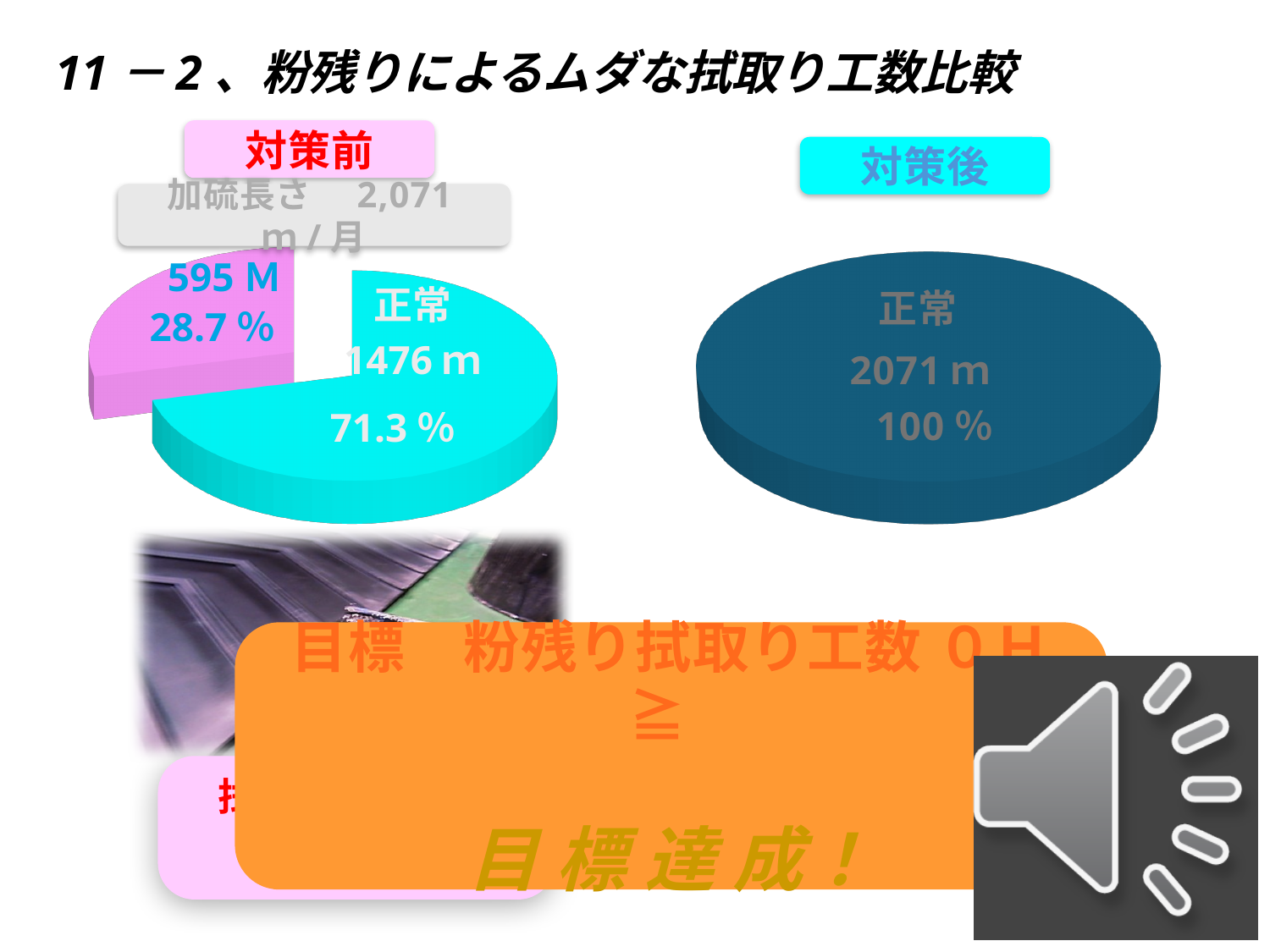
In the 対策前 pie chart, what percentage is shown for the pink slice? 28.7 % How many slices does the 対策前 pie chart have? 2 In the 対策前 pie chart, what percentage is shown for the 正常 slice? 71.3 % What colour is the 正常 slice in the 対策前 pie chart? cyan In the 対策前 pie chart, what value is shown for the pink slice? 595 M In the 対策前 pie chart, what length in metres is shown for the 正常 slice? 1476 m In the 対策後 pie chart, what length in metres is shown for 正常? 2071 m What kind of chart is used on the left side of the slide under 対策前? pie chart In the 対策前 pie chart, which slice is larger, the 正常 slice or the pink slice? 正常 In the 対策後 pie chart, what percentage is shown for 正常? 100 % How many slices does the 対策後 pie chart have? 1 What is the difference in percentage points between the 正常 slice and the pink slice in the 対策前 pie chart? 42.6 %